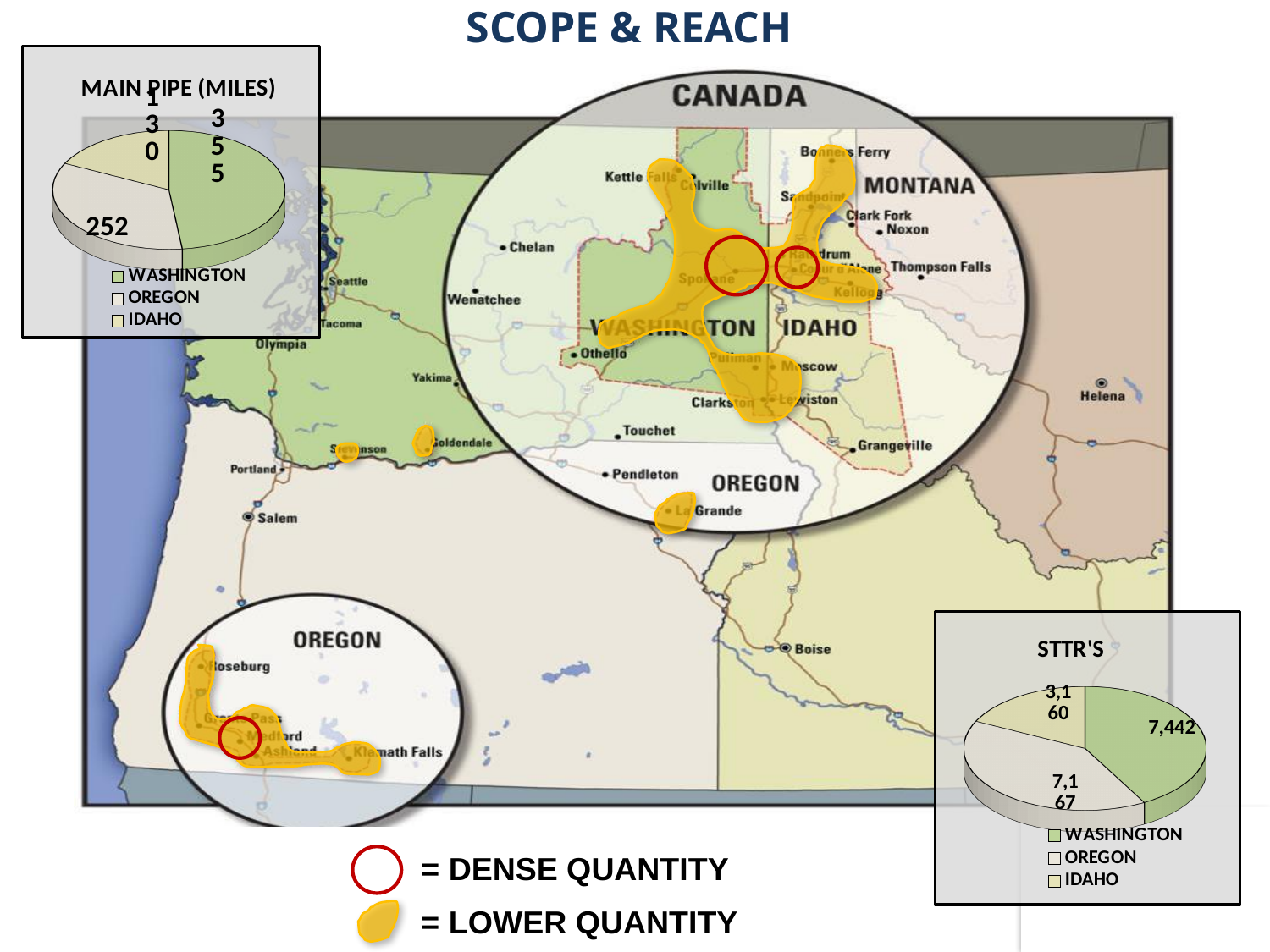
In the STTR'S chart, which state has the smallest value? Idaho In the MAIN PIPE (MILES) chart, what is the value for Oregon? 252 In the STTR'S chart, what is the total of the three values shown? 17,769 In the MAIN PIPE (MILES) chart, which state has the largest slice? Washington In the STTR'S chart, which colour represents Washington in the legend? Green In the MAIN PIPE (MILES) chart, how many states are shown? 3 In the STTR'S chart, what is the difference between the Washington and Oregon values? 275 In the STTR'S chart, what is the value for Oregon? 7,167 What kind of chart is the MAIN PIPE (MILES) chart? Pie chart In the MAIN PIPE (MILES) chart, what is the value for Washington? 355 In the STTR'S chart, what is the value for Washington? 7,442 In the MAIN PIPE (MILES) chart, which state has the smallest slice? Idaho